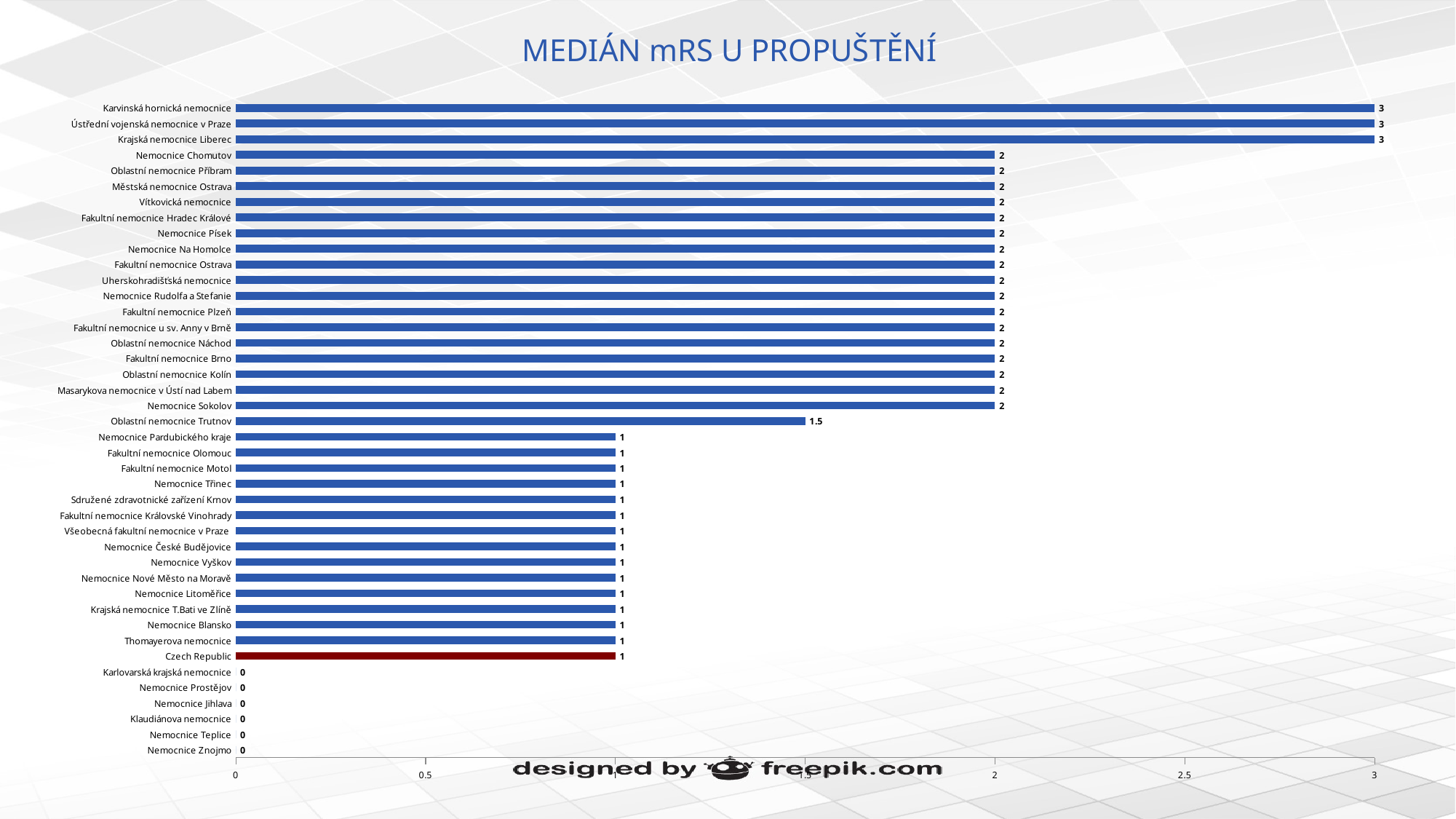
Which has a larger value, Nemocnice Chomutov or Fakultní nemocnice Motol? Nemocnice Chomutov What is the lowest value plotted on the chart? 0 What is the value shown for Krajská nemocnice Liberec? 3 What is the value shown for Czech Republic? 1 What is the median mRS at discharge for Oblastní nemocnice Trutnov? 1.5 What is the highest value plotted on the chart? 3 What is the difference between the values for Karvinská hornická nemocnice and Oblastní nemocnice Trutnov? 1.5 Which category's bar is coloured dark red instead of blue? Czech Republic How many hospitals/categories are listed on the chart? 42 What is the title of the chart? MEDIÁN mRS U PROPUŠTĚNÍ What type of chart is shown on the slide? Bar chart What is the value shown for Nemocnice Jihlava? 0